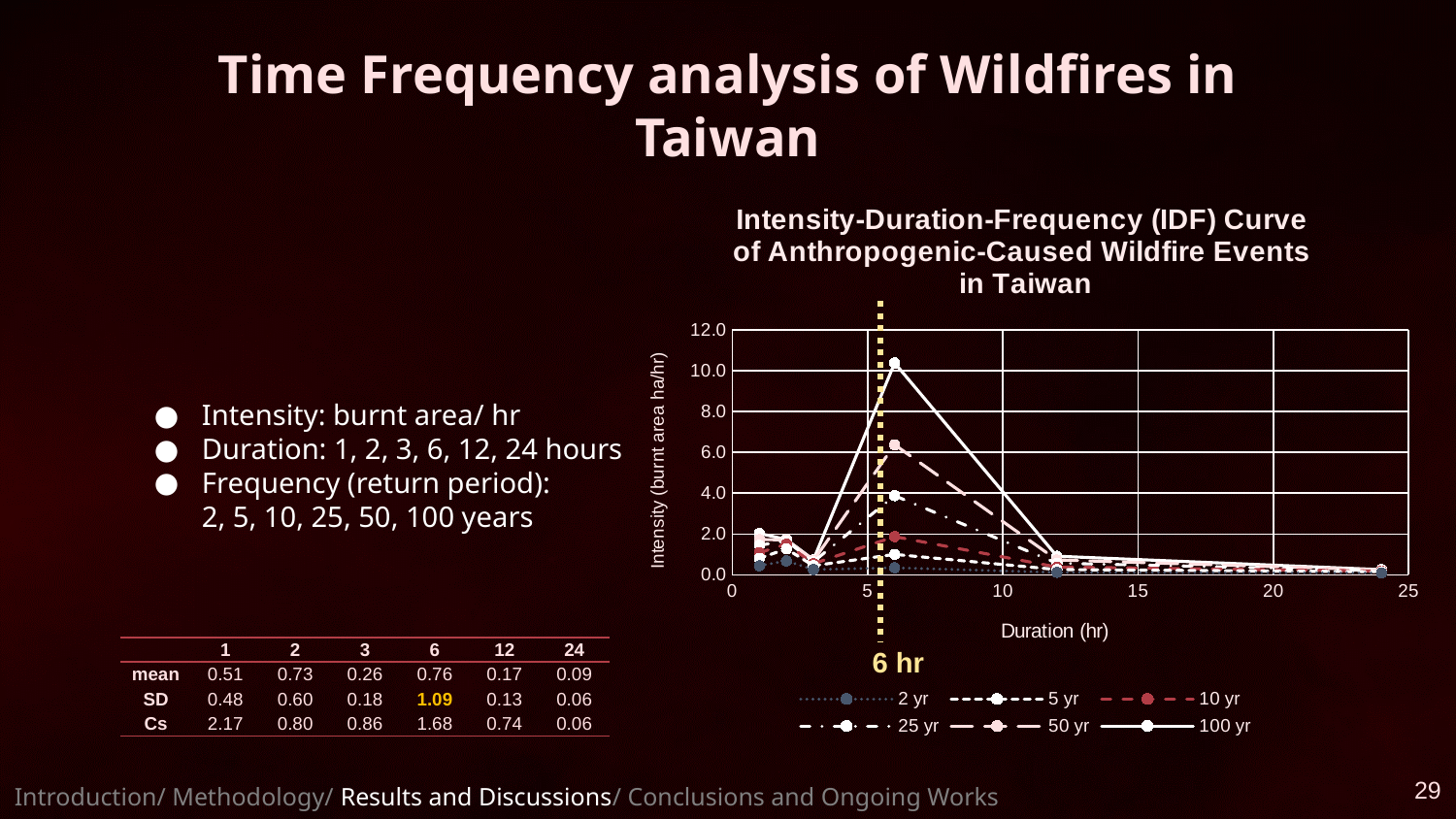
Is the intensity of the 2 yr series at 6 hr greater or less than 2.0? less Do the intensities of the 100 yr series rise or fall between 6 hr and 24 hr? fall Is the intensity of the 50 yr series at 6 hr greater or less than 4.0? greater How many series does the chart legend list? 6 Is the intensity of the 100 yr series at 6 hr greater or less than 8.0? greater What is the label of the x axis of the chart? Duration (hr) At a duration of 6 hr, which series has the larger intensity, 100 yr or 2 yr? 100 yr Which series reaches the highest intensity on the chart? 100 yr What is the title of the chart? Intensity-Duration-Frequency (IDF) Curve of Anthropogenic-Caused Wildfire Events in Taiwan At which duration does the 100 yr series reach its peak intensity? 6 hr What kind of chart is shown on the slide? line chart